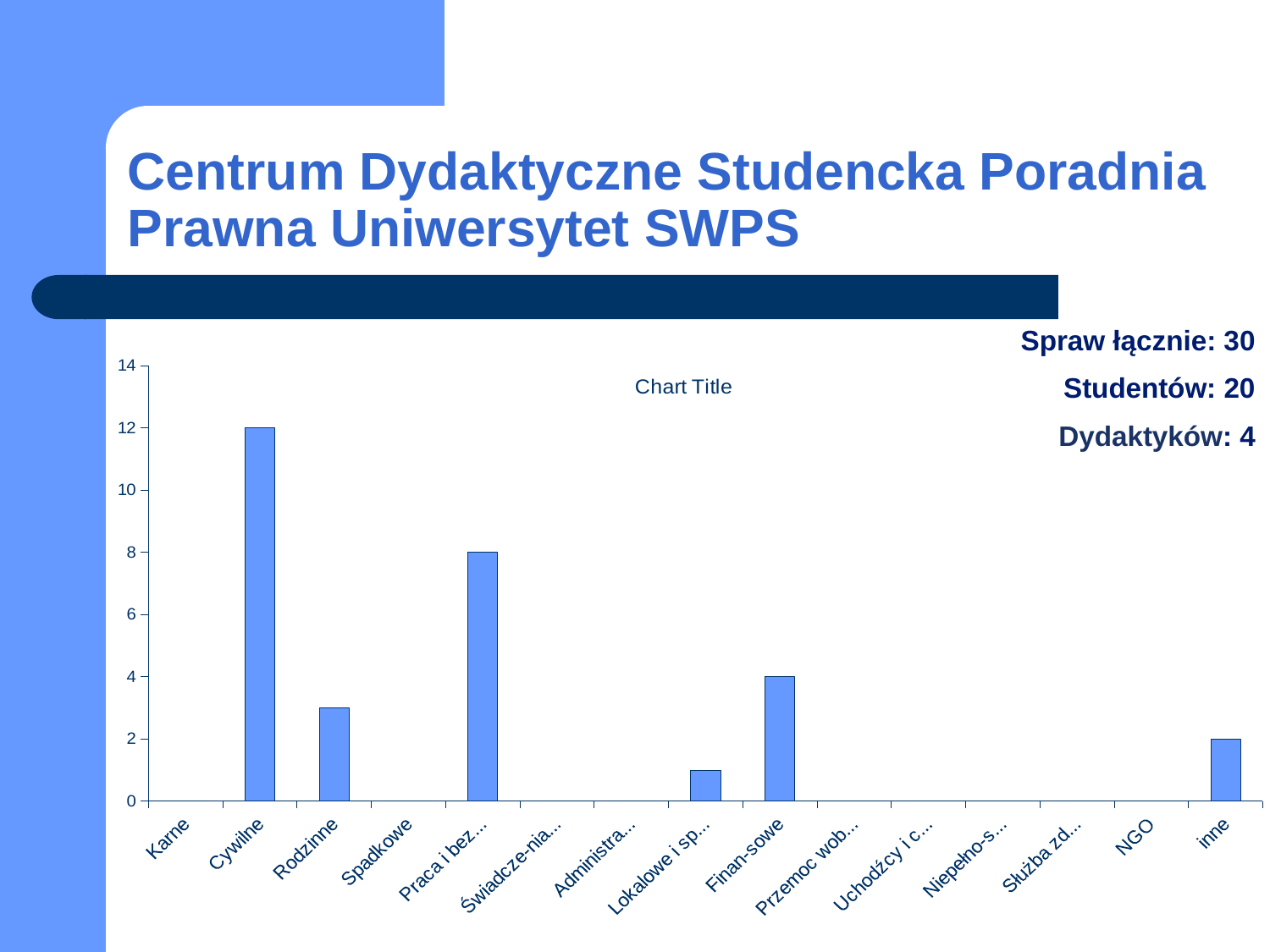
How many categories are shown on the x axis of the chart? 15 What is the difference between the values for Cywilne and Praca i bez...? 4 Which is larger, the value for Cywilne or the value for Finan-sowe? Cywilne Is the value for Rodzinne greater or less than 4? less What is the title shown on the chart? Chart Title What is the value for Finan-sowe? 4 What is the value for Praca i bez...? 8 What type of chart is shown on the slide? bar chart Is the value for Lokalowe i sp... greater or less than 2? less Which category has the highest bar in the chart? Cywilne What is the value for Cywilne? 12 What is the value for inne? 2